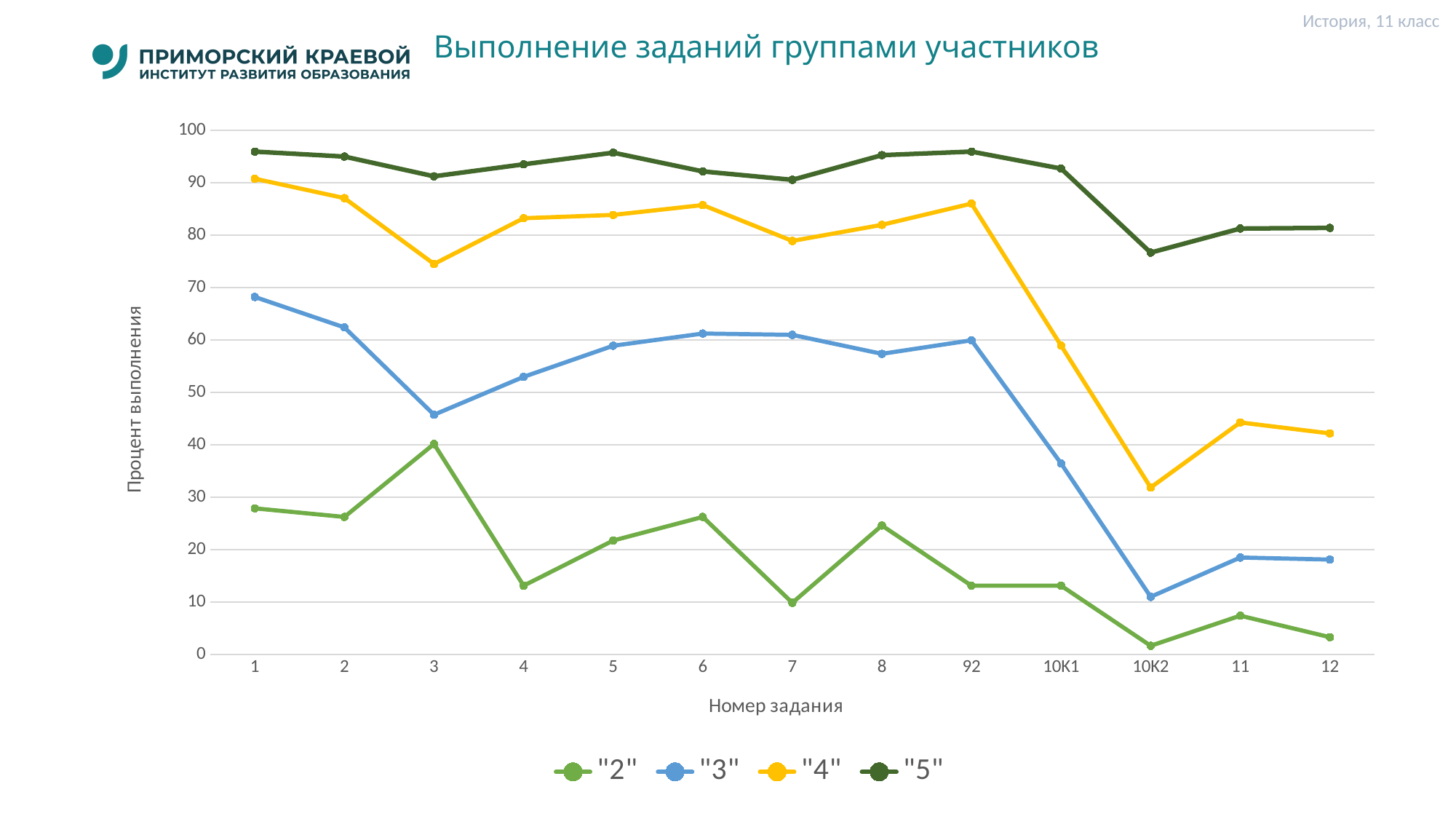
What kind of chart is shown on the slide? line chart Is the value for series "2" at task 3 greater or less than 30? greater How many task numbers are shown along the x axis? 13 For series "2", at which task is the value highest? 3 Is the value for series "3" at task 10К2 greater or less than 20? less Is the value for series "4" at task 10К2 greater or less than 40? less How many series does the legend list? 4 For series "2", at which task is the value lowest? 10К2 What is the title of the chart? Выполнение заданий группами участников At task 1, which series has the larger value, "3" or "4"? "4" For series "5", at which task is the value lowest? 10К2 What is the label of the vertical axis? Процент выполнения